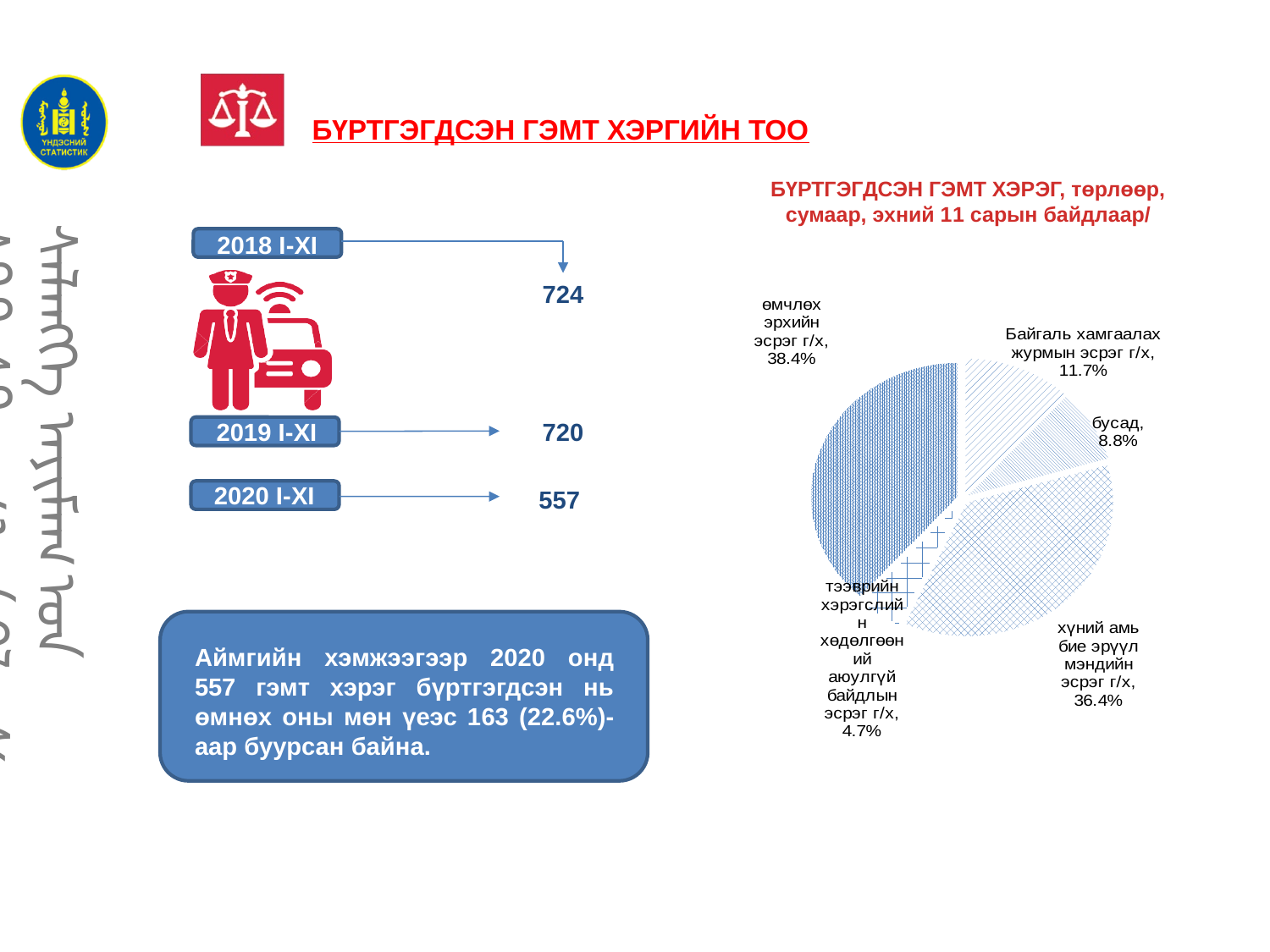
In the pie chart, what share is labelled for өмчлөх эрхийн эсрэг г/х? 38.4% In the pie chart, what share is labelled for бусад? 8.8% In the pie chart, what share is labelled for хүний амь бие эрүүл мэндийн эсрэг г/х? 36.4% How many slices does the pie chart have? 5 In the pie chart, which is larger: the share for Байгаль хамгаалах журмын эсрэг г/х or the share for бусад? Байгаль хамгаалах журмын эсрэг г/х What is the title of the pie chart? БҮРТГЭГДСЭН ГЭМТ ХЭРЭГ, төрлөөр, сумаар, эхний 11 сарын байдлаар/ In the pie chart, what is the difference in percentage points between Байгаль хамгаалах журмын эсрэг г/х and бусад? 2.9 Which slice of the pie chart has the largest share? өмчлөх эрхийн эсрэг г/х Which slice of the pie chart has the smallest share? тээврийн хэрэгслийн хөдөлгөөний аюулгүй байдлын эсрэг г/х In the pie chart, what share is labelled for Байгаль хамгаалах журмын эсрэг г/х? 11.7% In the pie chart, what share is labelled for тээврийн хэрэгслийн хөдөлгөөний аюулгүй байдлын эсрэг г/х? 4.7% What type of chart is shown on the right side of the slide? pie chart